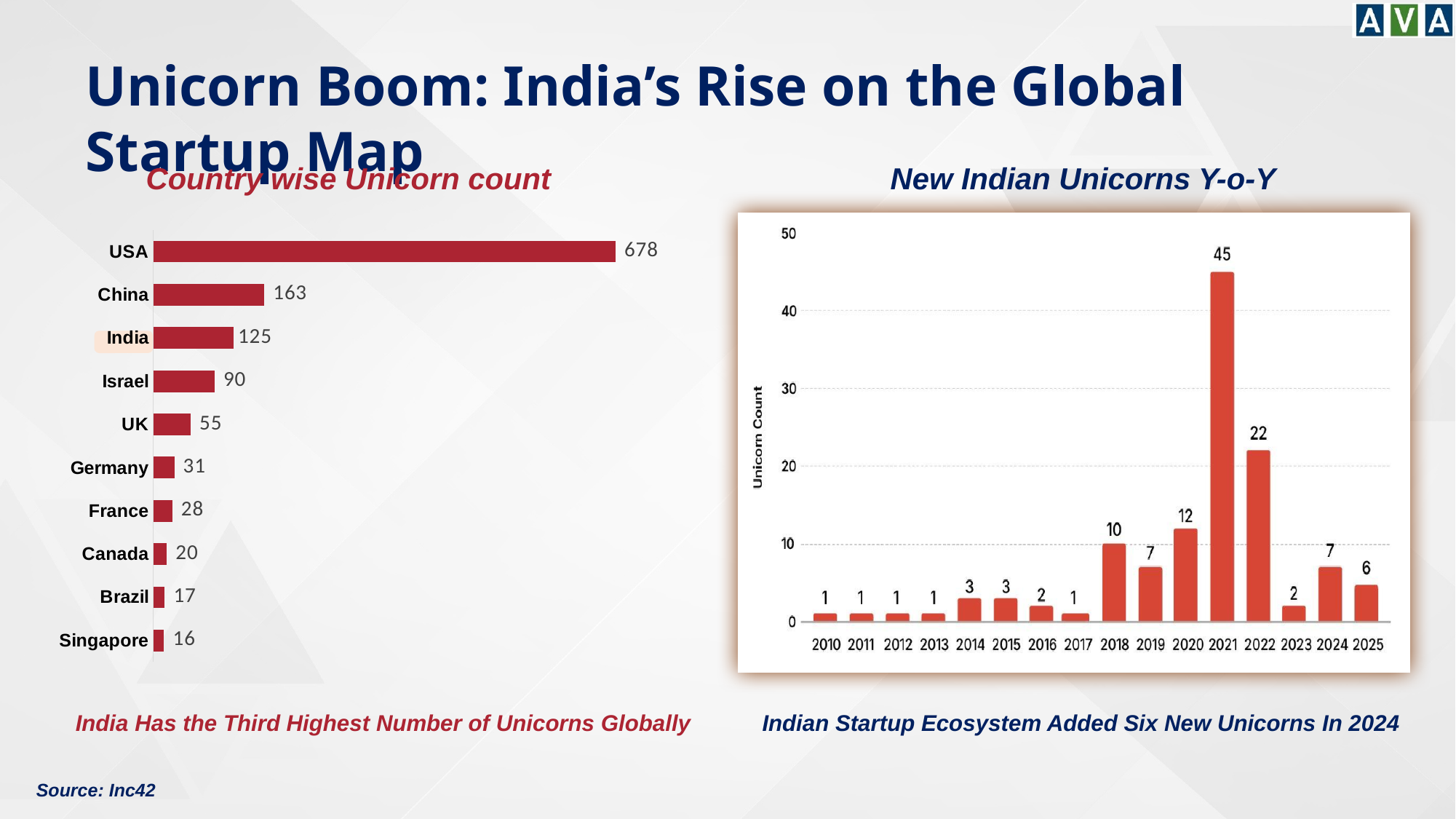
In the 'Country wise Unicorn count' chart, which has more unicorns, Germany or France? Germany In the 'New Indian Unicorns Y-o-Y' chart, which year had the highest number of new unicorns? 2021 What type of chart is the 'New Indian Unicorns Y-o-Y' chart? Bar chart In the 'Country wise Unicorn count' chart, what is the difference between the unicorn counts of China and India? 38 In the 'New Indian Unicorns Y-o-Y' chart, how many new unicorns were added in 2021? 45 In the 'Country wise Unicorn count' chart, which country has the highest unicorn count? USA In the 'New Indian Unicorns Y-o-Y' chart, how many years are shown on the x axis? 16 In the 'Country wise Unicorn count' chart, how many countries are shown? 10 In the 'Country wise Unicorn count' chart, which country has the lowest unicorn count? Singapore In the 'Country wise Unicorn count' chart, what is the unicorn count for India? 125 In the 'New Indian Unicorns Y-o-Y' chart, what is the difference between the number of new unicorns in 2021 and 2022? 23 In the 'New Indian Unicorns Y-o-Y' chart, what is the label of the y axis? Unicorn Count